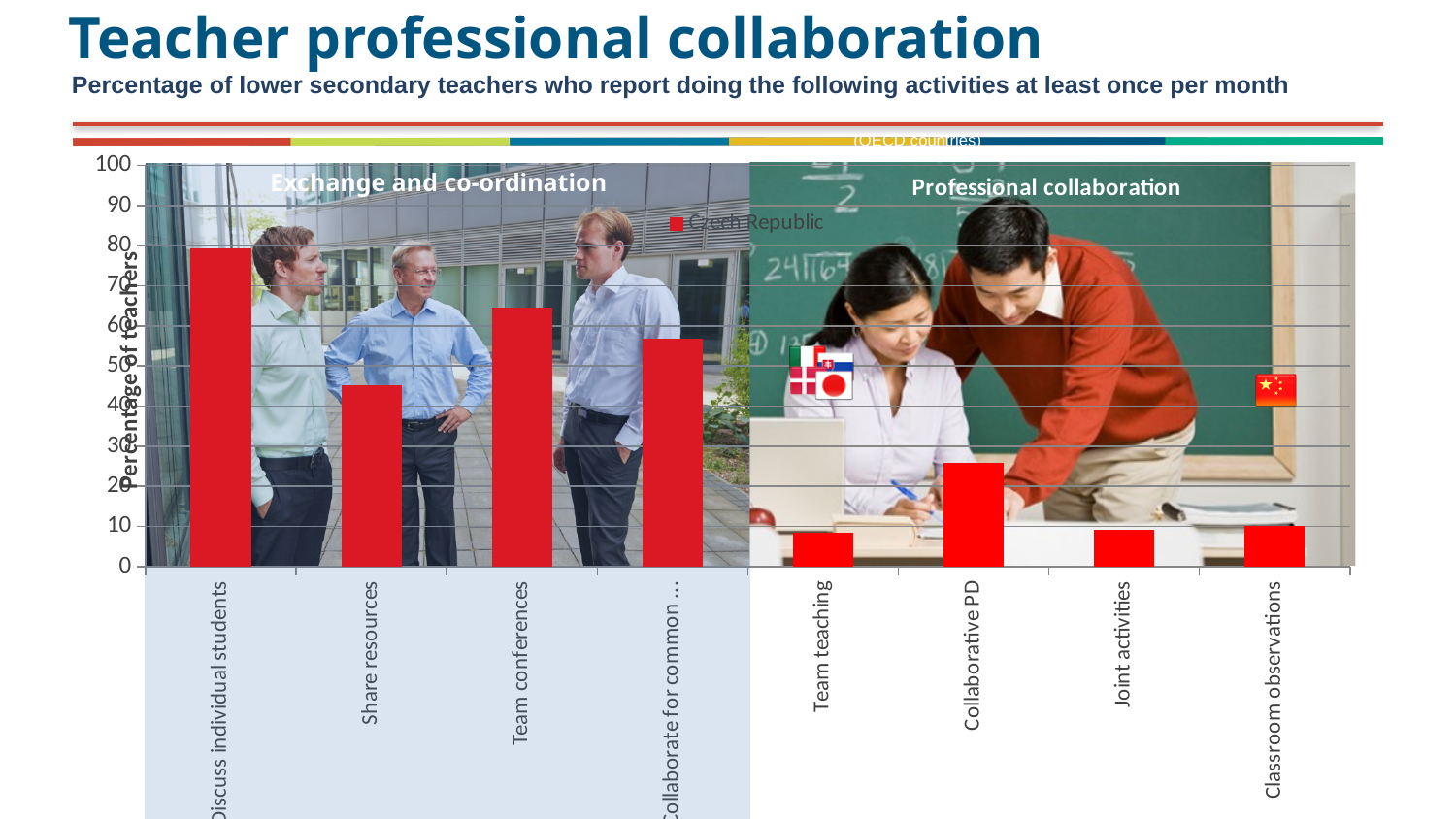
Which is larger, the value for Collaborative PD or the value for Team teaching? Collaborative PD How many series does the chart's legend list? 1 Which country is named in the chart's legend? Czech Republic Is the value for Team teaching greater or less than 20? less What kind of chart is shown on the slide? bar chart What are the two group headings shown above the bars in the chart? Exchange and co-ordination; Professional collaboration Is the value for Discuss individual students greater or less than 70? greater How many categories are plotted along the x axis of the chart? 8 Which is larger, the value for Share resources or the value for Team conferences? Team conferences Which category has the highest bar in the chart? Discuss individual students Is the value for Share resources greater or less than 50? less